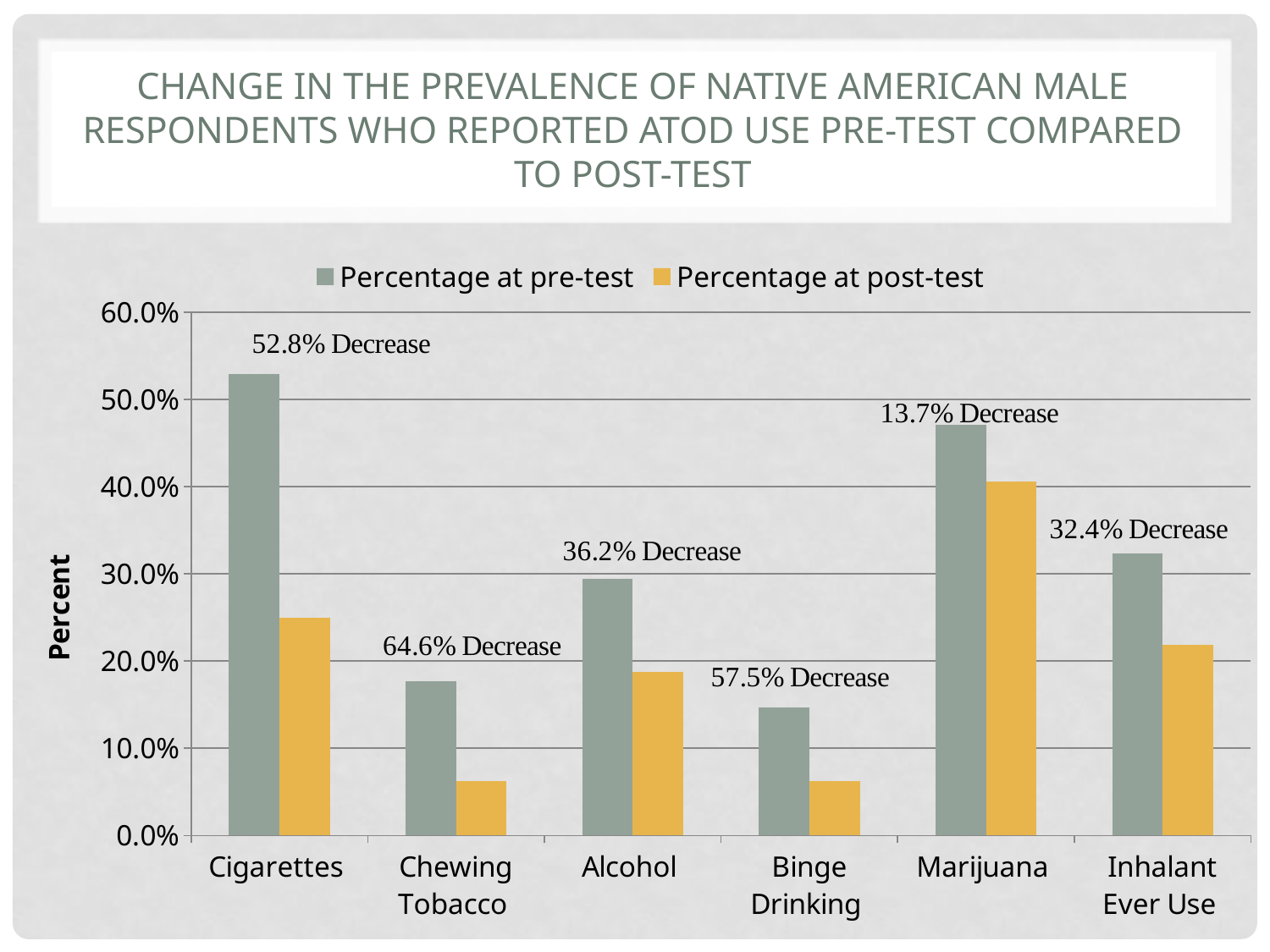
What percentage decrease is printed above the Chewing Tobacco bars? 64.6% Decrease Is the pre-test percentage for Cigarettes greater or less than 50.0%? greater Which is larger for Marijuana, the pre-test percentage or the post-test percentage? Pre-test What percentage decrease is printed above the Marijuana bars? 13.7% Decrease Is the post-test percentage for Chewing Tobacco greater or less than 10.0%? less What percentage decrease is printed above the Cigarettes bars? 52.8% Decrease Which category has the lowest pre-test percentage? Binge Drinking How many substance categories are shown on the x axis? 6 Which category has the highest post-test percentage? Marijuana What kind of chart is shown on the slide? Bar chart How many series does the legend list? 2 Which category has the highest pre-test percentage? Cigarettes